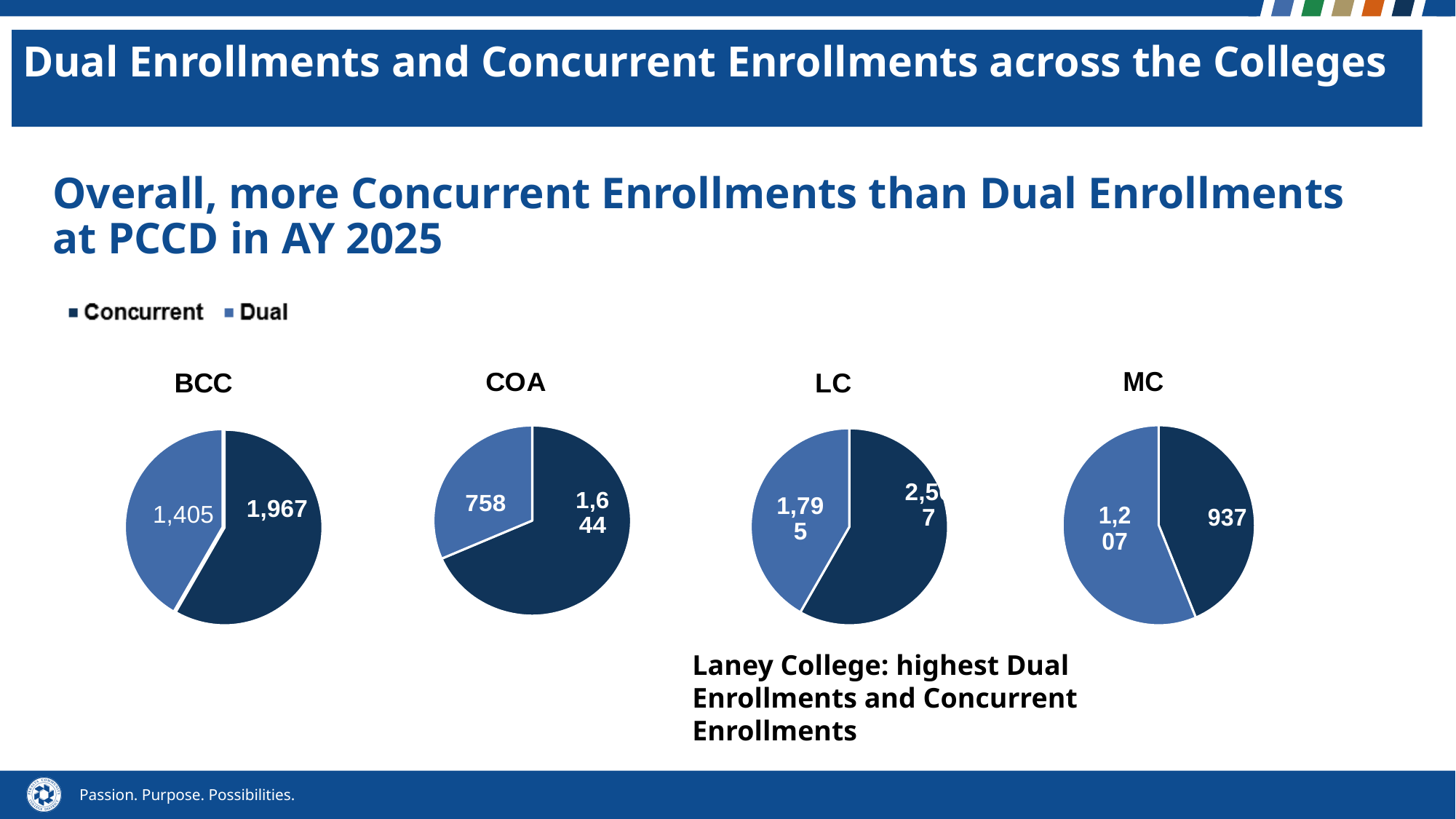
In the COA pie chart, what is the value for Concurrent? 1,644 In the MC pie chart, what is the value for Concurrent? 937 How many pie charts are on the slide? 4 In the BCC pie chart, what is the difference between Concurrent and Dual? 562 In the BCC pie chart, what is the value for Concurrent? 1,967 In the MC pie chart, what is the value for Dual? 1,207 What kind of charts are shown on the slide? Pie charts In the MC pie chart, which is larger, Concurrent or Dual? Dual In the LC pie chart, what is the value for Dual? 1,795 How many series does the legend list? 2 In the COA pie chart, what is the value for Dual? 758 In the BCC pie chart, what is the value for Dual? 1,405